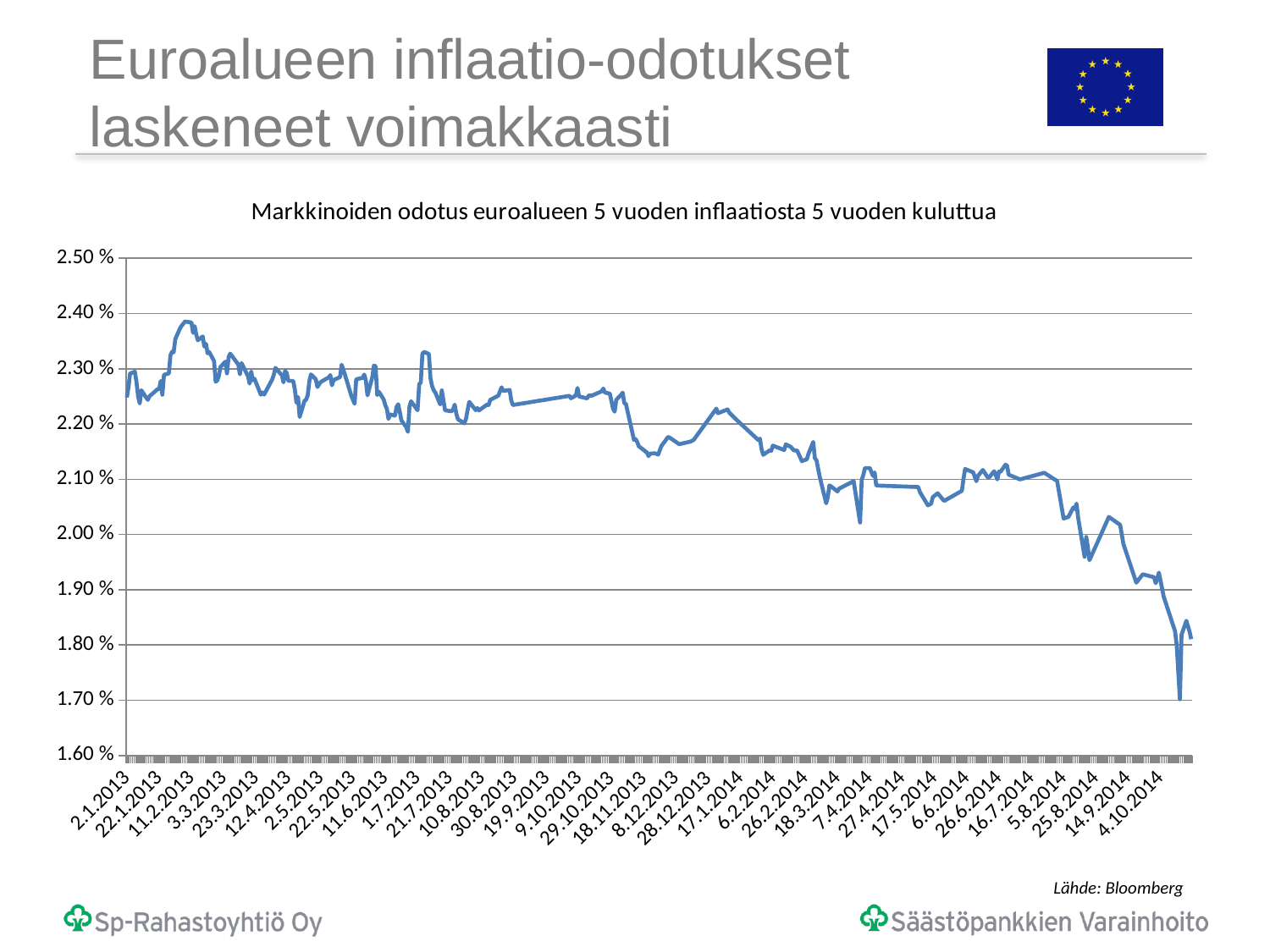
Is the lowest point of the line greater or less than 1.80 %? less Is the value at 11.2.2013 greater or less than 2.30 %? greater Is the value at 2.1.2013 greater or less than 2.20 %? greater Is the value at 2.1.2013 larger or smaller than the value at 4.10.2014? larger What is the title of the chart? Markkinoiden odotus euroalueen 5 vuoden inflaatiosta 5 vuoden kuluttua What kind of chart is shown on the slide? line chart Overall, do the values rise or fall from left to right along the x axis? fall What is the highest value shown on the y axis? 2.50 % How many data series are plotted in the chart? 1